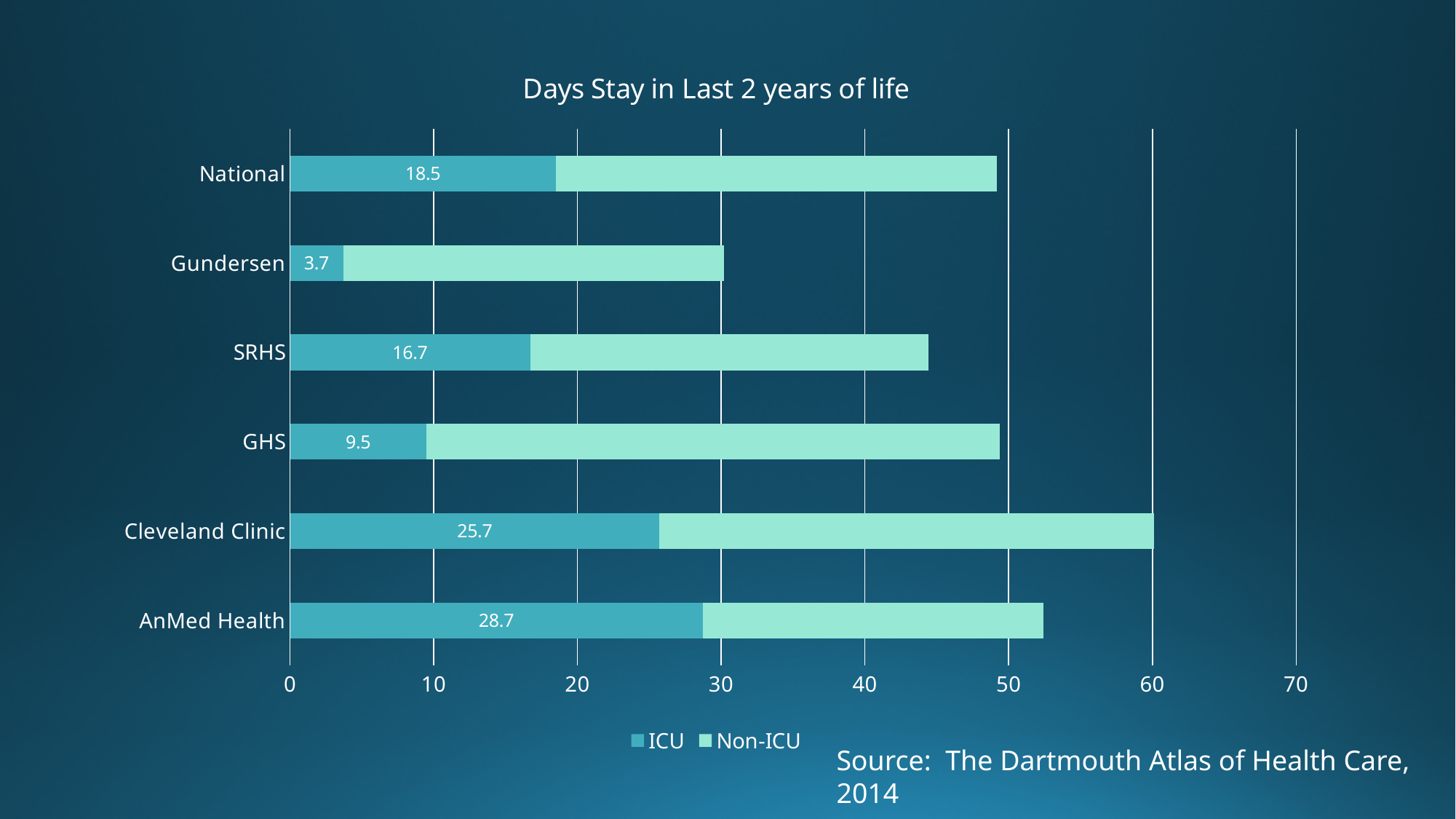
What is the ICU value for AnMed Health? 28.7 Is the total stacked value for Cleveland Clinic greater or less than 50? greater How many categories are shown on the chart? 6 Which has a larger ICU value, National or SRHS? National What is the difference between the ICU values for AnMed Health and Cleveland Clinic? 3.0 What is the ICU value for Cleveland Clinic? 25.7 Is the total stacked value for SRHS greater or less than 40? greater What type of chart is shown on the slide? Stacked bar chart Which category has the lowest ICU value? Gundersen Which category has the highest ICU value? AnMed Health What is the ICU value for Gundersen? 3.7 How many series does the legend list? 2